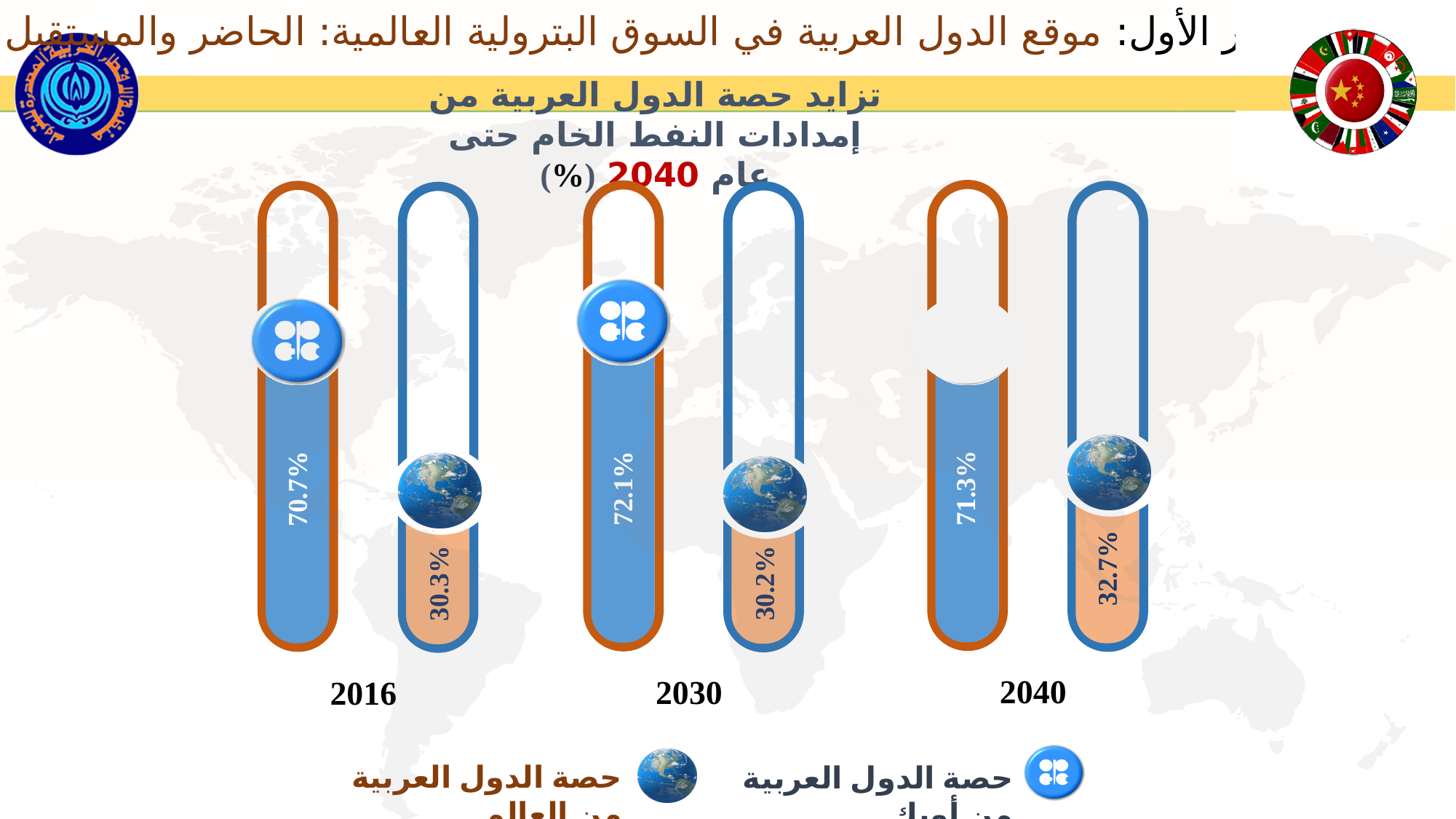
Which is larger in 2040: the share of Arab countries from OPEC or from the world? Share from OPEC What is the difference between the share of Arab countries from OPEC and from the world in 2016? 40.4% What is the share of Arab countries from the world in 2040? 32.7% How many years are shown on the x axis? 3 What is the share of Arab countries from the world in 2030? 30.2% How many series does the legend list? 2 In which year is the share of Arab countries from OPEC highest? 2030 What is the share of Arab countries from OPEC in 2030? 72.1% In which year is the share of Arab countries from the world lowest? 2030 What kind of chart is shown on the slide? Bar chart By how much does the share of Arab countries from the world change from 2030 to 2040? 2.5% What is the share of Arab countries from OPEC in 2016? 70.7%